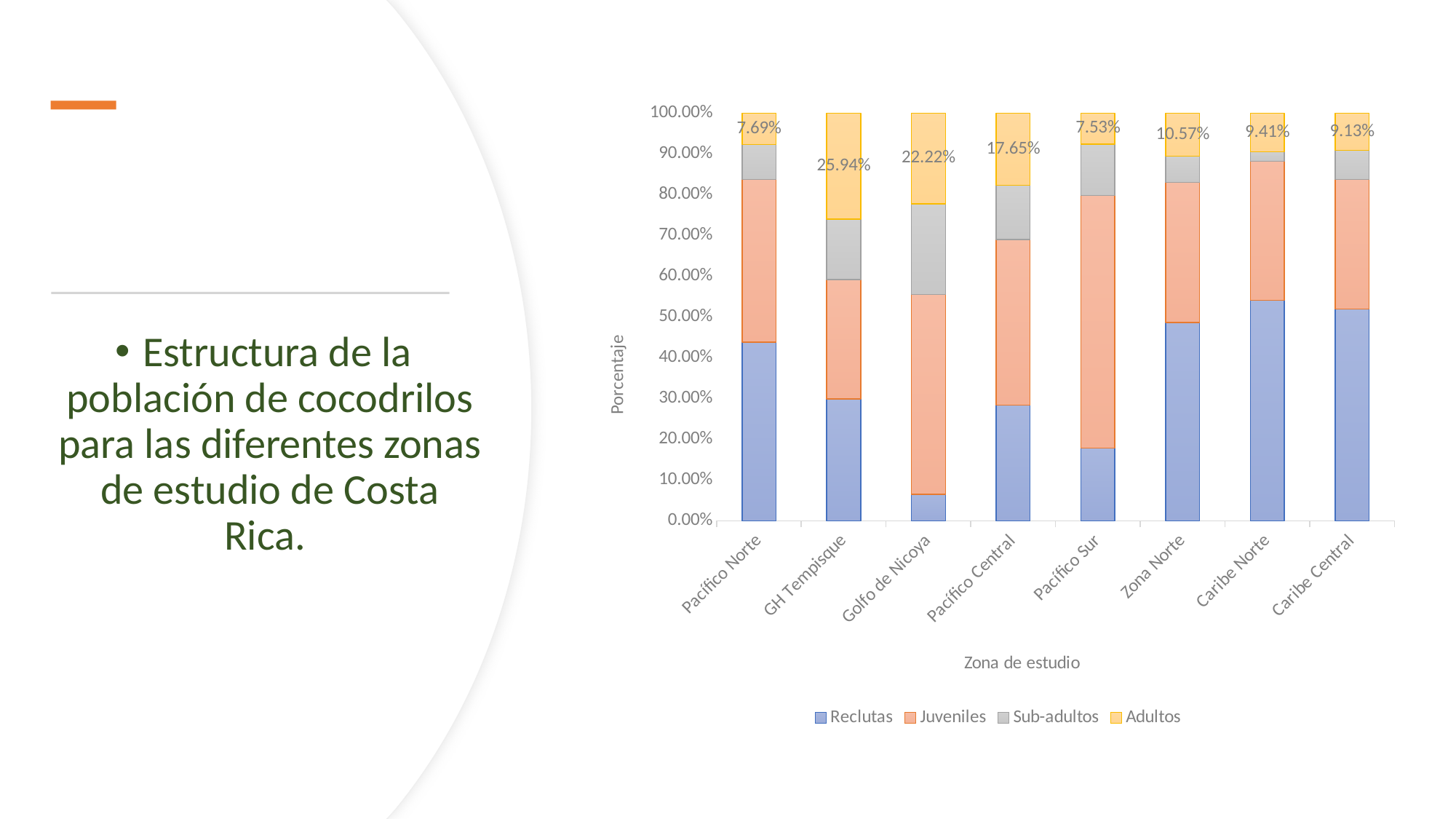
What kind of chart is shown on the slide? Stacked bar chart Is the Reclutas value for Golfo de Nicoya greater or less than 10.00%? less What is the Adultos value for GH Tempisque? 25.94% What is the Adultos value for Pacífico Central? 17.65% What is the difference between the Adultos values for GH Tempisque and Golfo de Nicoya? 3.72% Which has a larger Adultos value, Zona Norte or Caribe Norte? Zona Norte How many series does the legend list? 4 What is the Adultos value for Caribe Central? 9.13% Which zone has the lowest Adultos percentage? Pacífico Sur Which zone has the highest Adultos percentage? GH Tempisque Is the Reclutas value for Caribe Norte greater or less than 50.00%? greater How many study zones are shown on the x axis? 8